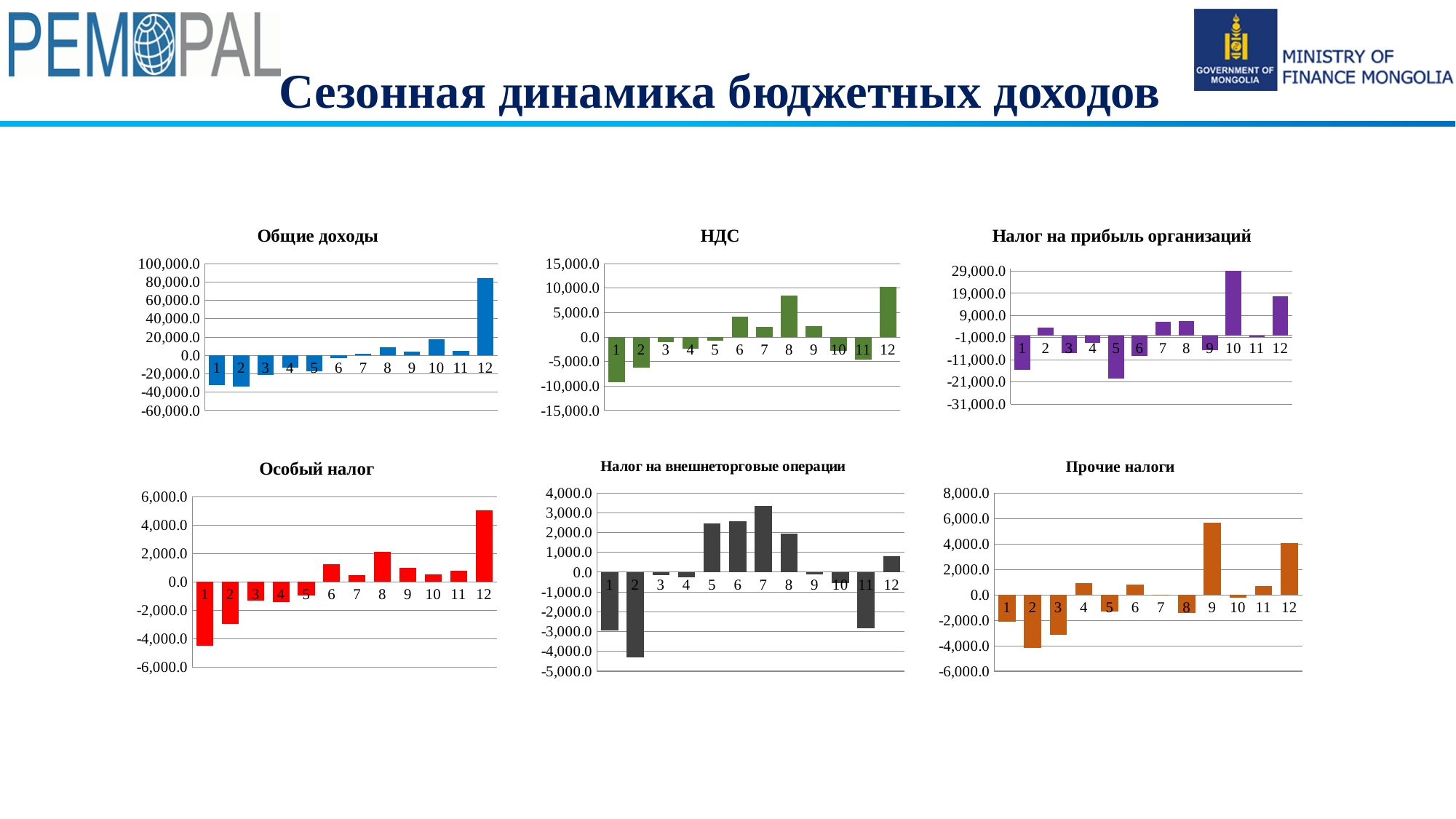
In the 'Налог на внешнеторговые операции' chart, is the value for category 2 greater or less than -4,000.0? less What kind of chart is the 'Общие доходы' chart? bar chart How many charts are shown on the slide? 6 In the 'Налог на прибыль организаций' chart, which category has the highest value? 10 In the 'НДС' chart, which category has the lowest value? 1 In the 'Прочие налоги' chart, is the value for category 9 greater or less than 4,000.0? greater In the 'Налог на внешнеторговые операции' chart, which category has the highest value? 7 In the 'Налог на прибыль организаций' chart, which category has the lowest value? 5 In the 'Общие доходы' chart, which category has the highest value? 12 In the 'Особый налог' chart, is the value for category 12 greater or less than 4,000.0? greater How many categories are shown on the x axis of the 'НДС' chart? 12 In the 'Прочие налоги' chart, which is larger, the value for category 9 or category 12? 9